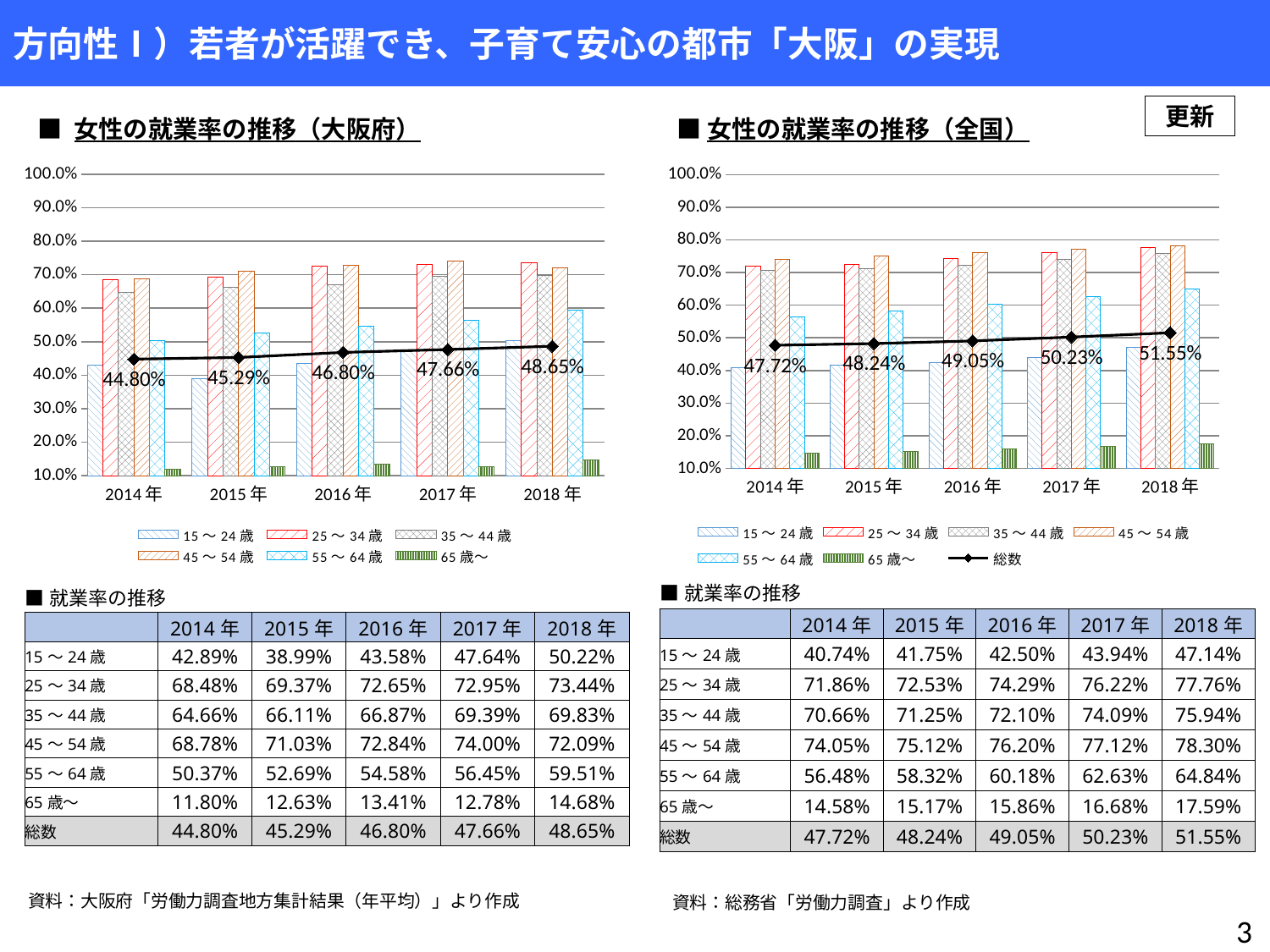
In the left chart (大阪府), is the 65歳～ bar for 2018年 greater or less than 20.0%? less In the left chart (大阪府), which age group has the lowest bar in 2018年? 65歳～ In the right chart (全国), what is the difference between the labelled 総数 values for 2018年 and 2014年? 3.83% In the left chart (大阪府), by how much did the labelled 総数 value increase from 2014年 to 2018年? 3.85% How many entries does the legend of the right chart (全国) list? 7 In the left chart (女性の就業率の推移（大阪府）), what is the 総数 value labelled for 2018年? 48.65% In the left chart (大阪府), what is the 総数 value labelled for 2016年? 46.80% How many entries does the legend of the left chart (大阪府) list? 6 In the right chart (全国), does the 総数 line rise or fall from 2014年 to 2018年? rises Which is larger: the 総数 value for 2018年 in the left chart (大阪府) or in the right chart (全国)? the right chart (全国), 51.55% In the right chart (女性の就業率の推移（全国）), what is the 総数 value labelled for 2014年? 47.72% How many years are shown on the x axis of the left chart (大阪府)? 5